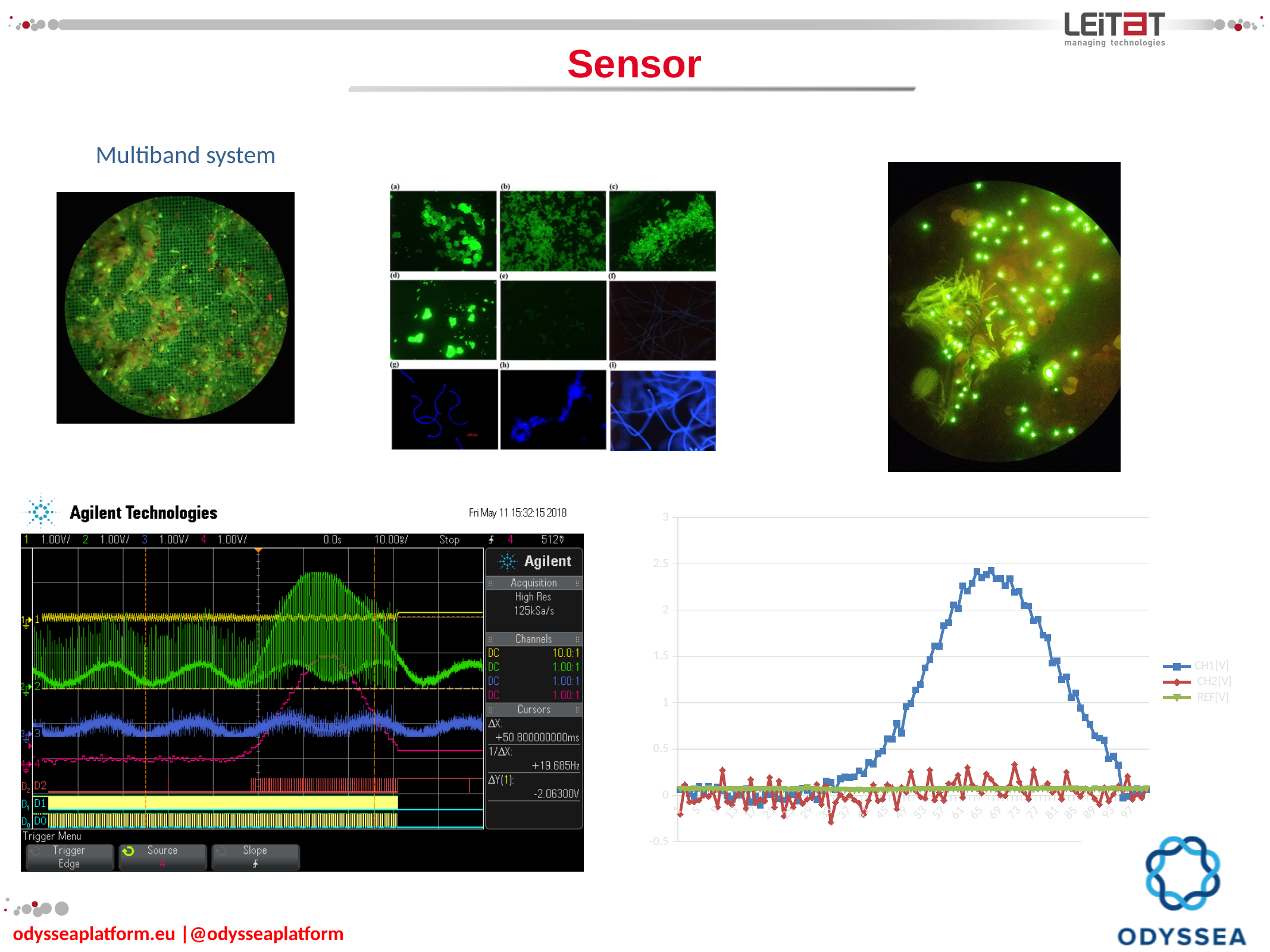
What is the highest value shown on the y axis of the bottom-right chart? 3 In the bottom-right chart, are the values of REF[V] greater or less than 0.5? less In the bottom-right chart, which series is plotted in blue? CH1[V] In the bottom-right chart, which series reaches the highest value? CH1[V] What is the lowest value shown on the y axis of the bottom-right chart? -0.5 In the bottom-right chart, is the peak value of CH1[V] greater or less than 2.5? less In the bottom-right chart, which series is larger around x = 65: CH1[V] or CH2[V]? CH1[V] How many series does the legend of the bottom-right chart list? 3 What are the three series named in the legend of the bottom-right chart? CH1[V], CH2[V], REF[V] In the bottom-right chart, does CH1[V] rise or fall between x = 37 and x = 65? rise In the bottom-right chart, is the peak value of CH1[V] greater or less than 2? greater What kind of chart is shown at the bottom right of the slide? line chart